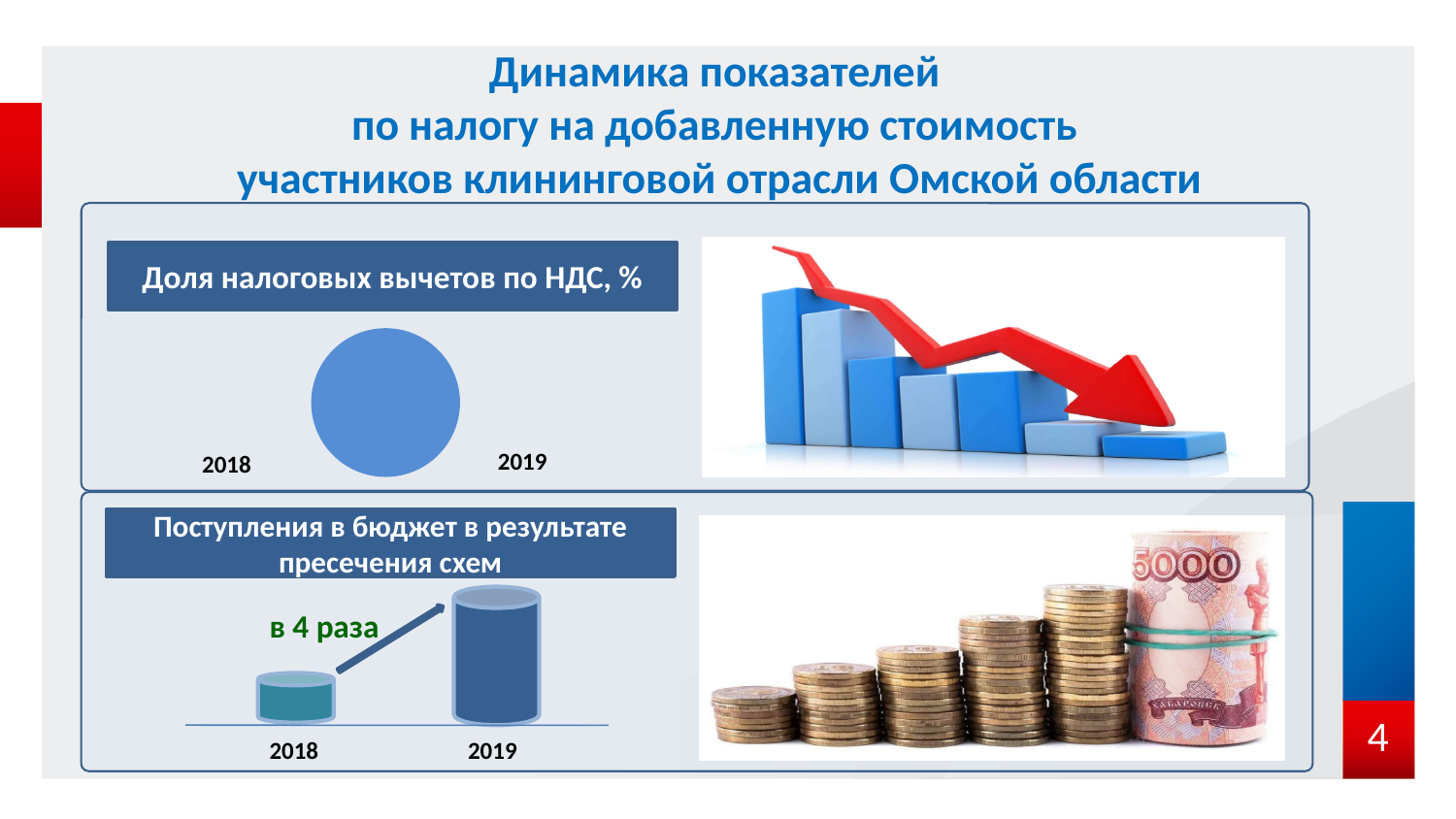
What annotation is written next to the arrow in the chart "Поступления в бюджет в результате пресечения схем"? в 4 раза What is the title of the chart in the upper left panel of the slide? Доля налоговых вычетов по НДС, % In the chart "Поступления в бюджет в результате пресечения схем", which year has the larger value, 2018 or 2019? 2019 What type of chart is shown under the heading "Доля налоговых вычетов по НДС, %"? pie chart In the chart "Поступления в бюджет в результате пресечения схем", which year has the highest value? 2019 How many years are shown on the x axis of the chart "Поступления в бюджет в результате пресечения схем"? 2 In the chart "Поступления в бюджет в результате пресечения схем", do the values rise or fall from 2018 to 2019? rise In the chart "Поступления в бюджет в результате пресечения схем", which year has the lowest value? 2018 What type of chart is shown under the heading "Поступления в бюджет в результате пресечения схем"? bar chart